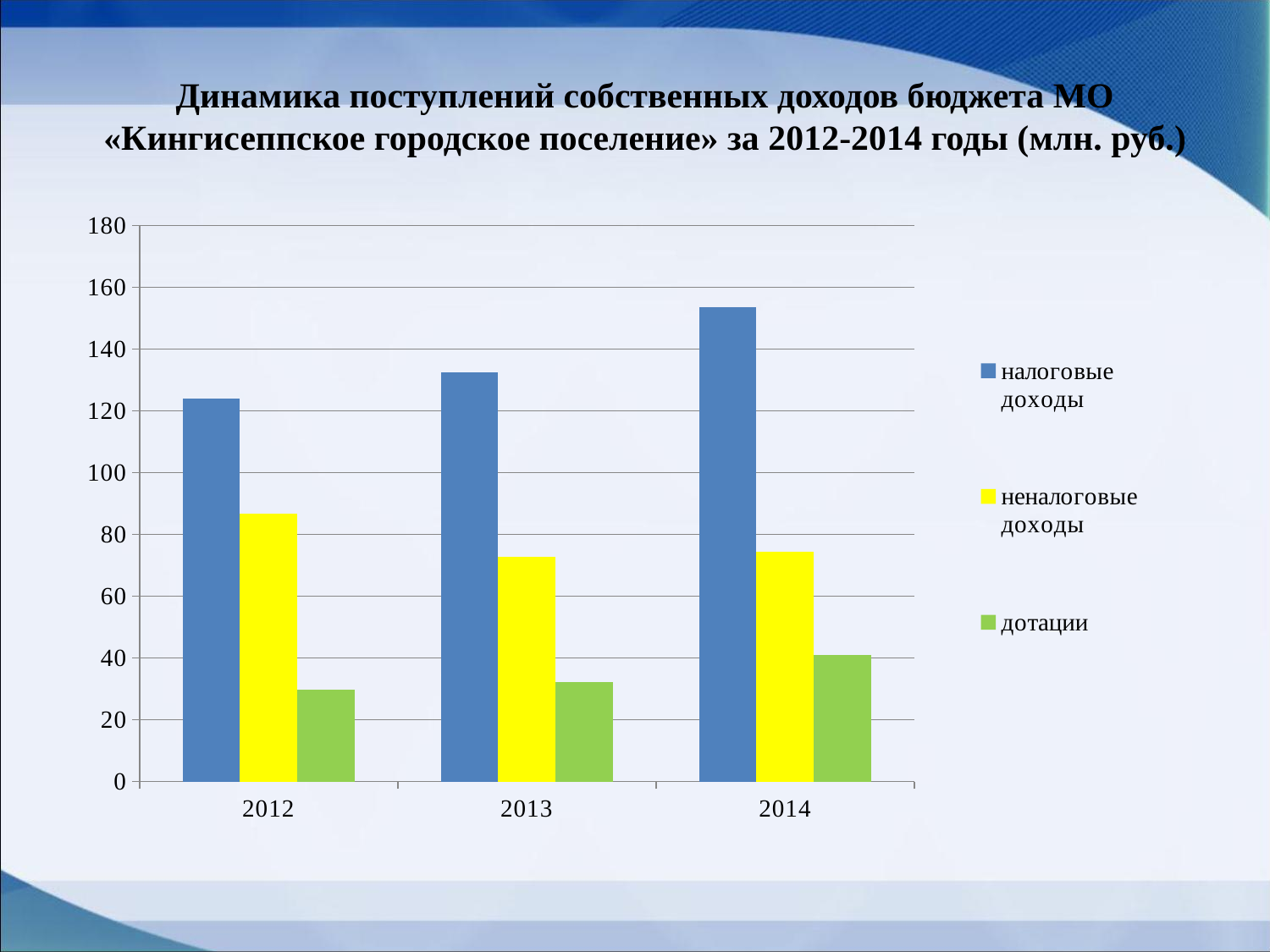
What kind of chart is shown on the slide? bar chart Is the value for налоговые доходы in 2014 greater or less than 140? greater Is the value for дотации in 2012 greater or less than 40? less Do налоговые доходы rise or fall from 2012 to 2014? rise In which year are налоговые доходы the highest? 2014 Is the value for неналоговые доходы in 2013 greater or less than 80? less How many years are shown on the x axis? 3 What colour are the bars for дотации? green In which year are неналоговые доходы the highest? 2012 How many series does the legend list? 3 Which is larger in 2013: налоговые доходы or неналоговые доходы? налоговые доходы